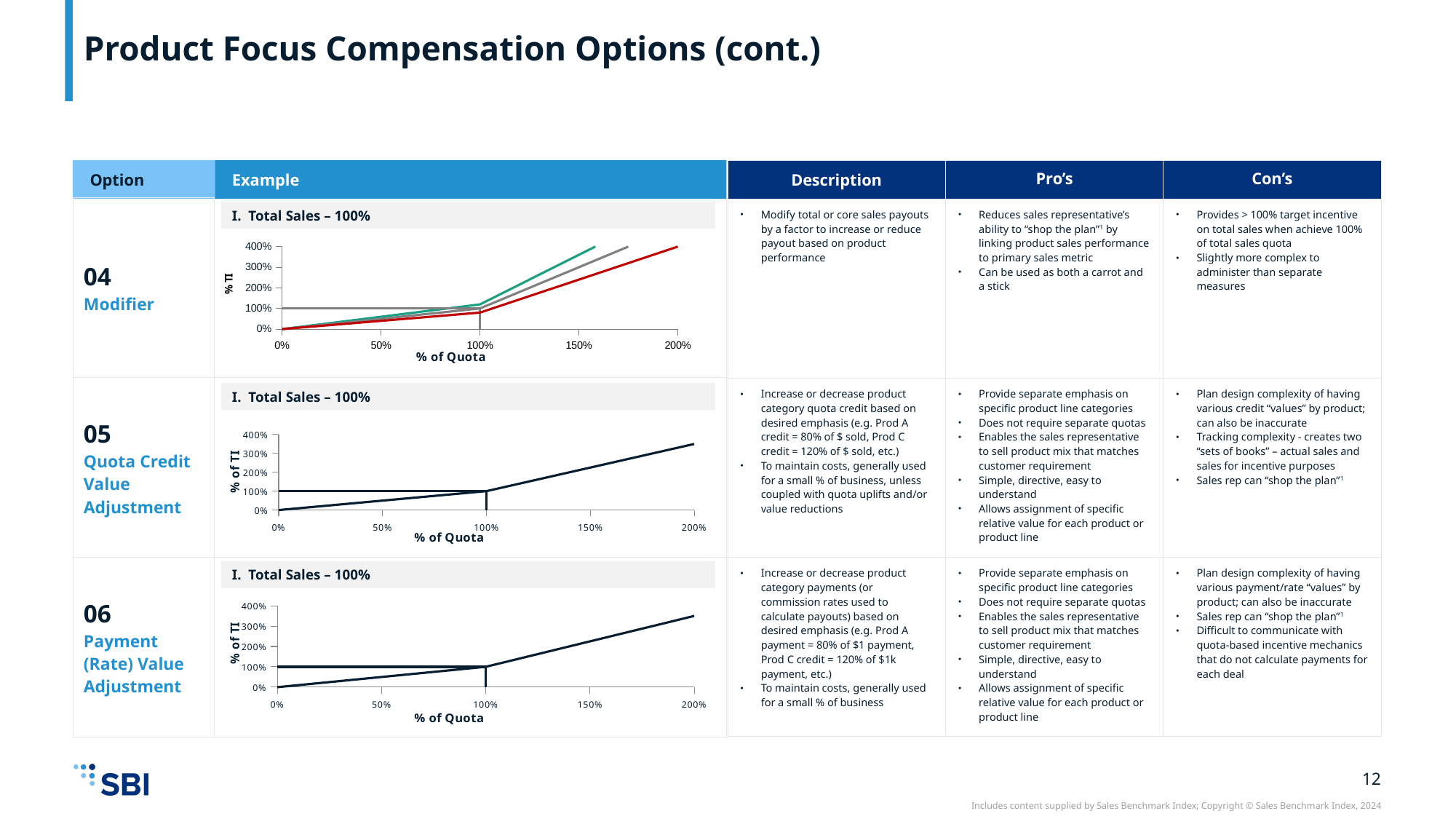
In the Option 04 Modifier chart, how many lines are plotted? 3 In the Option 06 Payment (Rate) Value Adjustment chart, does the line rise or fall as % of Quota increases? Rise What kind of chart is shown in the Example column for Option 04 Modifier? Line chart In the Option 04 Modifier chart, is the value of the red line at 50% of quota greater or less than 100%? less In the Option 04 Modifier chart, do the plotted lines rise or fall as % of Quota increases? Rise In the Option 05 Quota Credit Value Adjustment chart, how many tick labels are shown on the x axis? 5 In the Option 06 Payment (Rate) Value Adjustment chart, is the value of the line at 150% of quota greater or less than 100%? greater In the Option 04 Modifier chart, what is the label of the x axis? % of Quota In the Option 04 Modifier chart, what is the label of the y axis? % TI In the Option 05 Quota Credit Value Adjustment chart, is the value of the line at 50% of quota greater or less than 100%? less